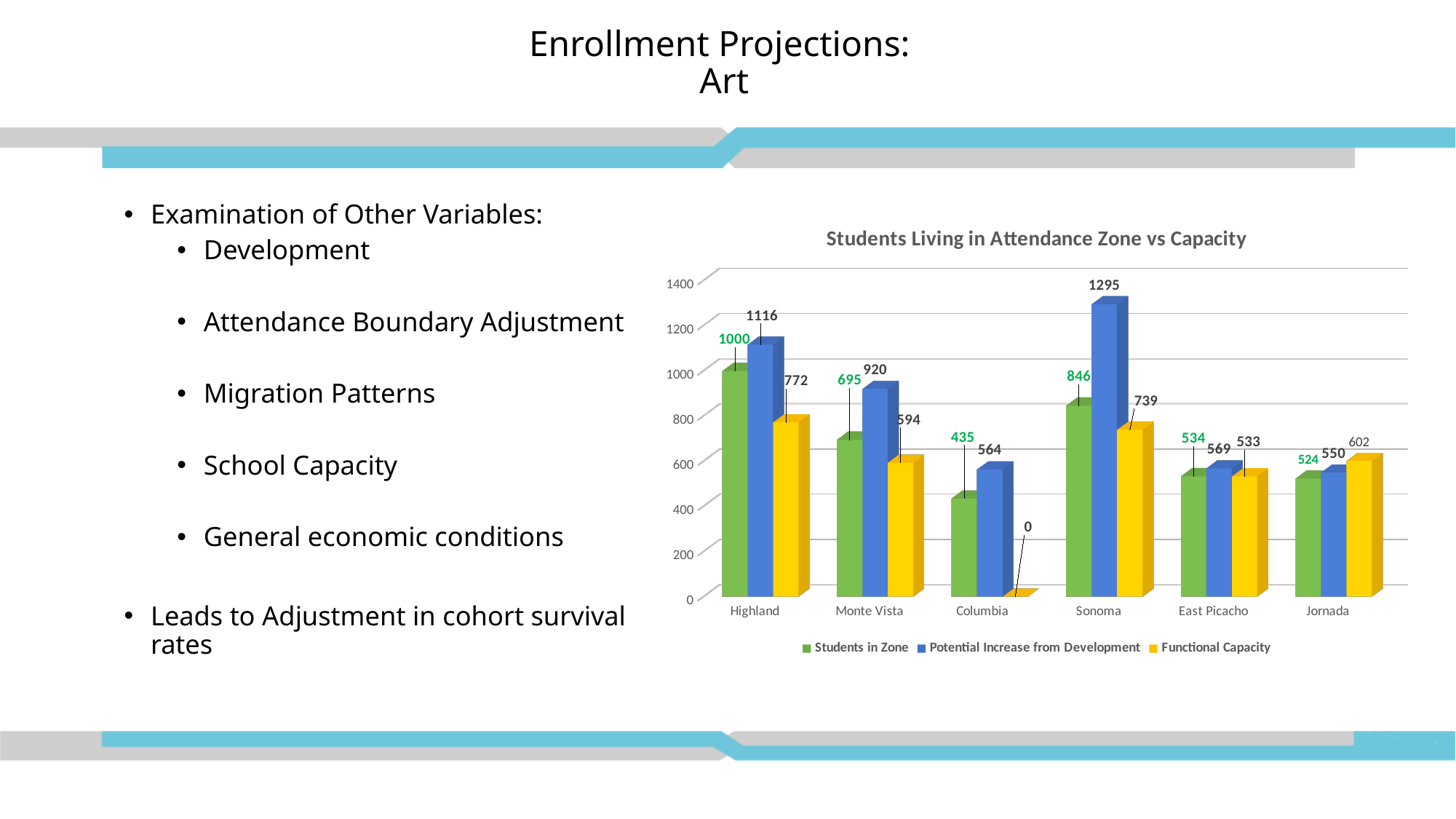
How many schools (categories) are shown on the x axis of the chart? 6 What is the difference between the Potential Increase from Development and the Functional Capacity for Sonoma? 556 Which school has the highest Potential Increase from Development value? Sonoma Which is larger for Jornada: Students in Zone or Functional Capacity? Functional Capacity What is the Students in Zone value for Highland? 1000 Which school has the lowest Students in Zone value? Columbia What is the Functional Capacity value for Columbia? 0 How many series does the chart legend list? 3 What kind of chart is shown on the slide? Bar chart What is the Potential Increase from Development value for Sonoma? 1295 What is the title of the chart? Students Living in Attendance Zone vs Capacity What is the Functional Capacity value for Monte Vista? 594